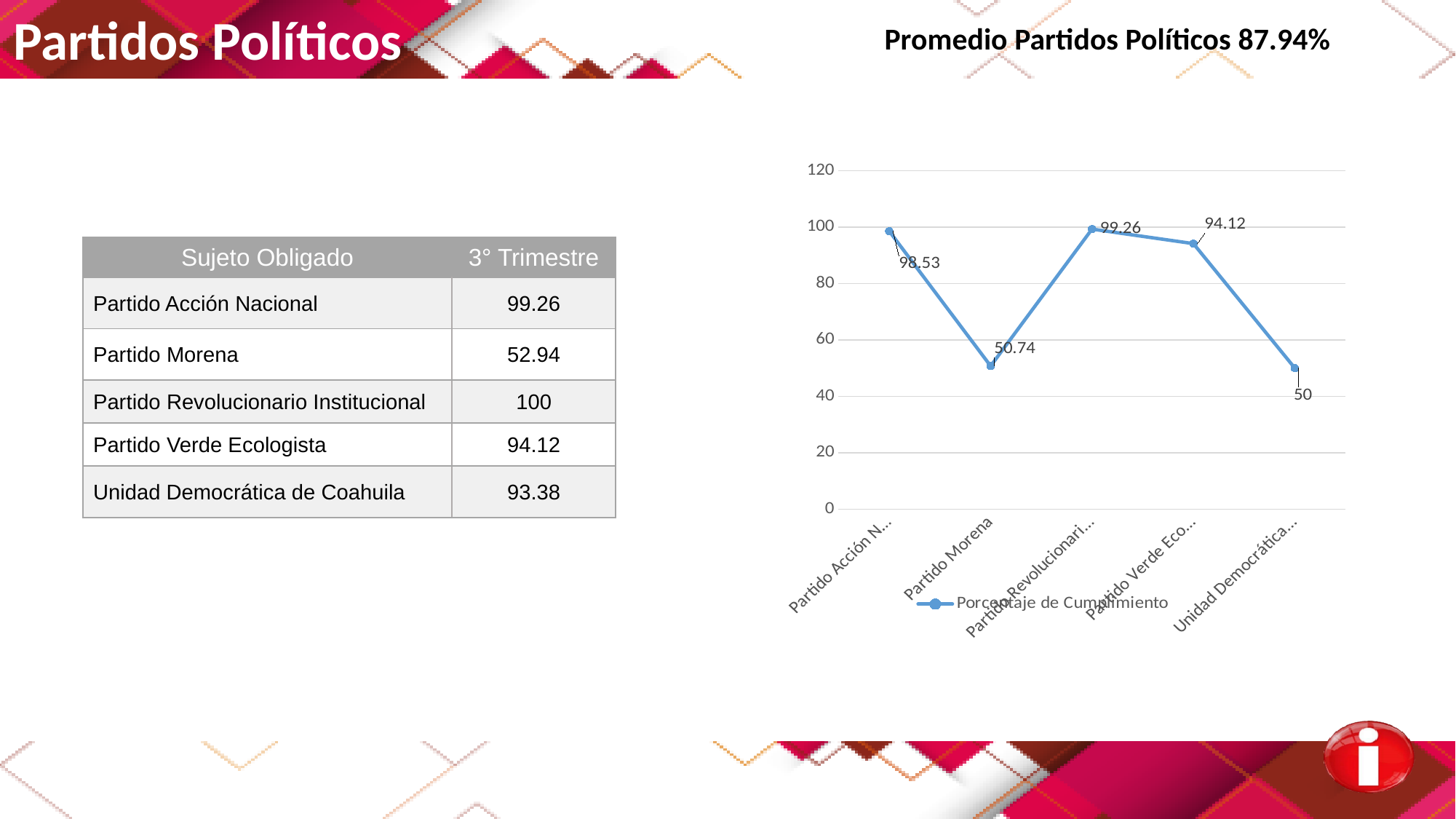
What is the value plotted for Partido Morena in the chart? 50.74 What is the value of the first data point (Partido Acción N...) in the chart? 98.53 How many series does the chart legend list? 1 What is the value of the last data point (Unidad Democrática...) in the chart? 50 Which is larger in the chart, the value for Partido Acción N... or the value for Partido Verde Eco...? Partido Acción N... What is the value plotted for Partido Verde Eco... in the chart? 94.12 What is the name of the series shown in the chart legend? Porcentaje de Cumplimiento What is the difference between the values for Partido Revolucionari... and Partido Morena in the chart? 48.52 What kind of chart is shown on the slide? line chart Which category has the lowest value in the chart? Unidad Democrática... How many data points are plotted in the chart? 5 Which category has the highest value in the chart? Partido Revolucionari...